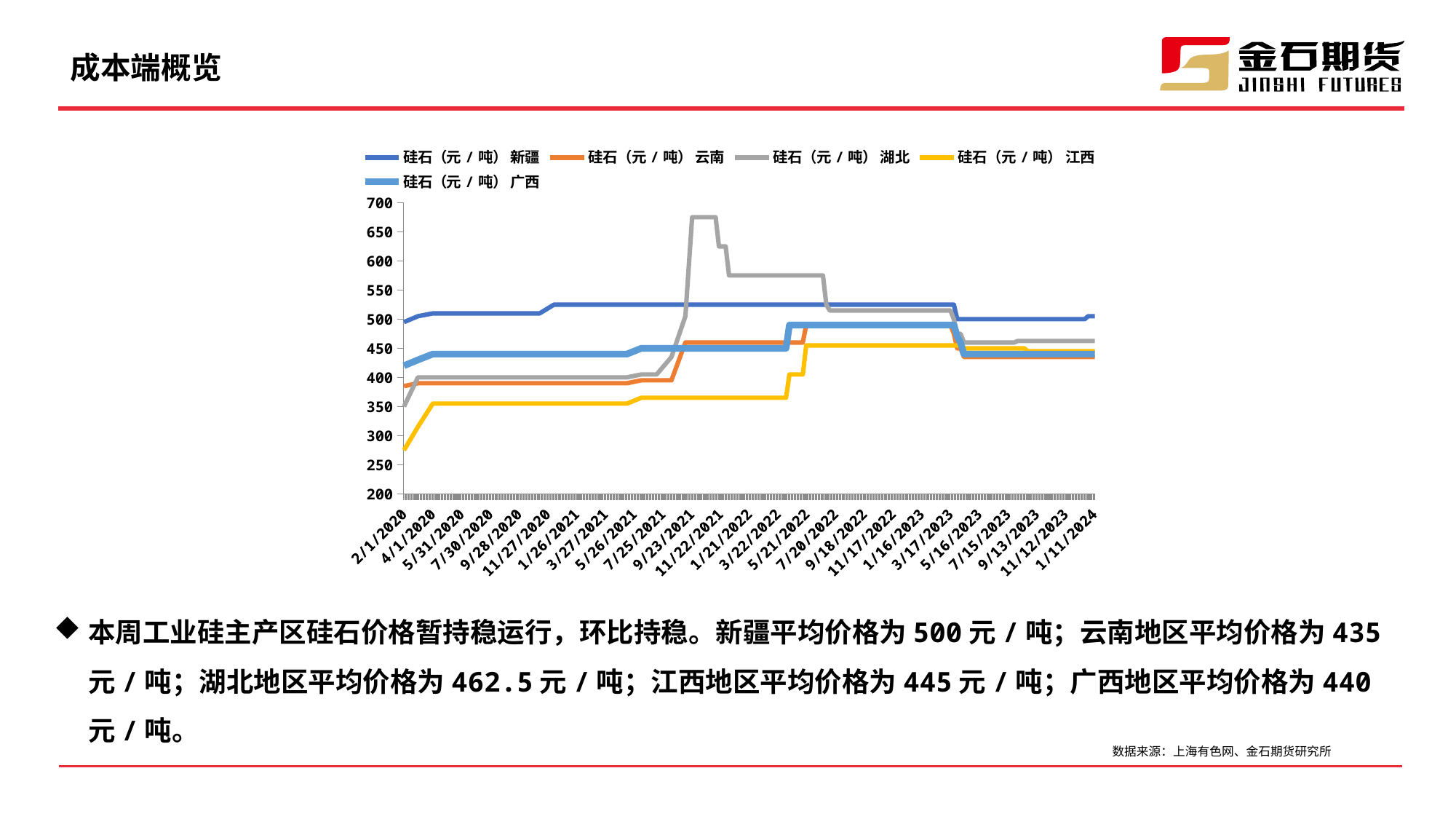
Is the value for 硅石（元/吨）新疆 at 1/21/2022 greater or less than 500? greater Is the value for 硅石（元/吨）云南 at 2/1/2020 greater or less than 400? less What colour is the 硅石（元/吨）江西 line in the legend? yellow What kind of chart is shown on the slide? line chart Is the peak value of 硅石（元/吨）湖北 around 11/22/2021 greater or less than 650? greater Which series has the lowest value at the start of the chart (2/1/2020)? 硅石（元/吨）江西 How many series does the legend list? 5 Which series reaches the highest value anywhere on the chart? 硅石（元/吨）湖北 At 2/1/2020, which is higher: 硅石（元/吨）新疆 or 硅石（元/吨）江西? 硅石（元/吨）新疆 At 11/22/2021, which is higher: 硅石（元/吨）湖北 or 硅石（元/吨）新疆? 硅石（元/吨）湖北 Does the 硅石（元/吨）湖北 line rise or fall from 11/22/2021 to 1/11/2024? fall